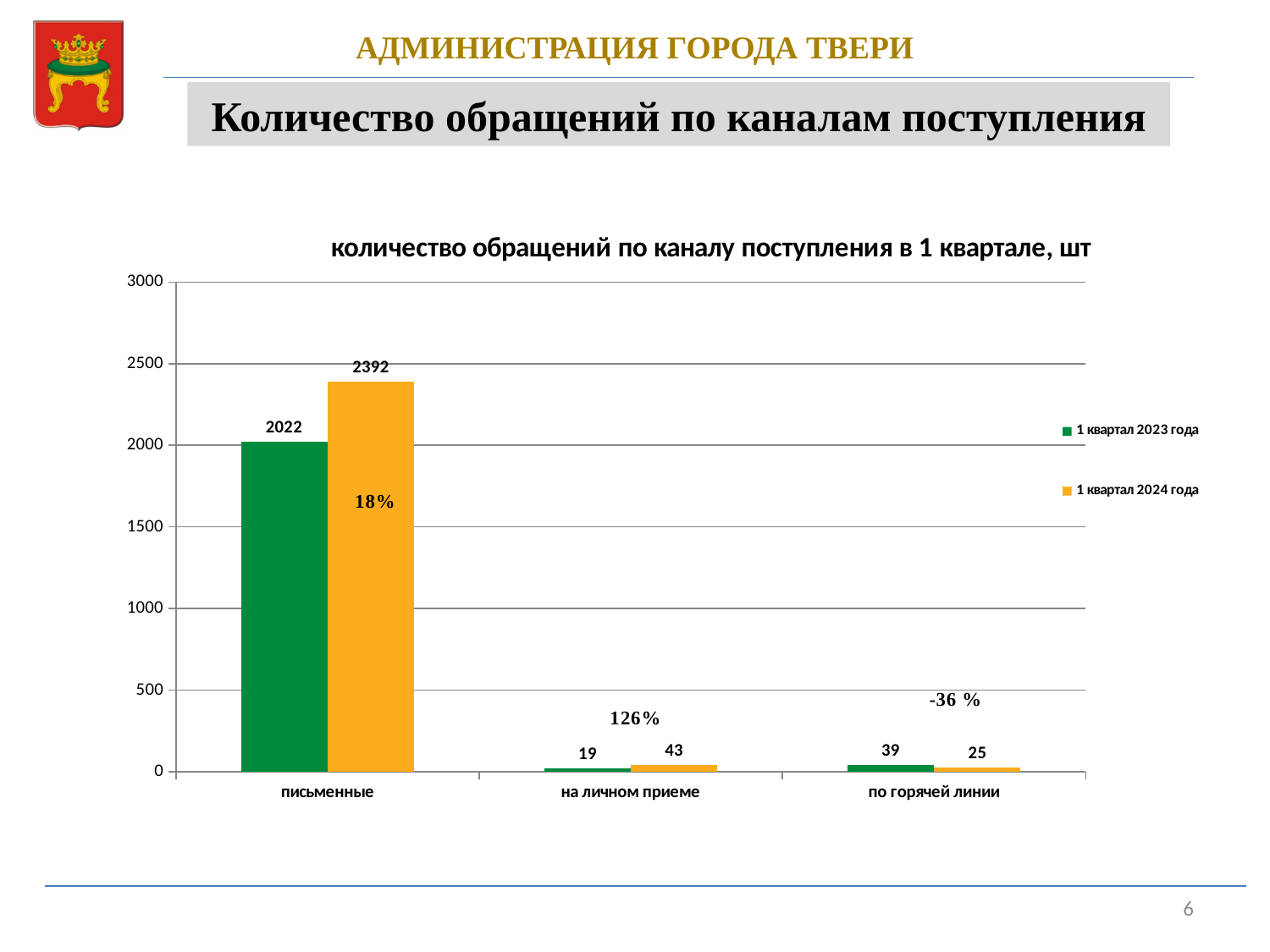
Which is larger for по горячей линии: the 1 квартал 2023 года value or the 1 квартал 2024 года value? 1 квартал 2023 года What is the value for по горячей линии in 1 квартал 2024 года? 25 Is the value for письменные in 1 квартал 2023 года greater or less than 2500? less What is the value for на личном приеме in 1 квартал 2023 года? 19 Which category has the highest value in 1 квартал 2023 года? письменные How many series does the legend list? 2 Which category has the lowest value in 1 квартал 2024 года? по горячей линии What percentage change is printed above the bars for на личном приеме? 126% What kind of chart is shown on the slide? bar chart What is the difference between the 1 квартал 2024 года and 1 квартал 2023 года values for письменные? 370 How many categories are shown on the x axis? 3 What is the value for письменные in 1 квартал 2024 года? 2392